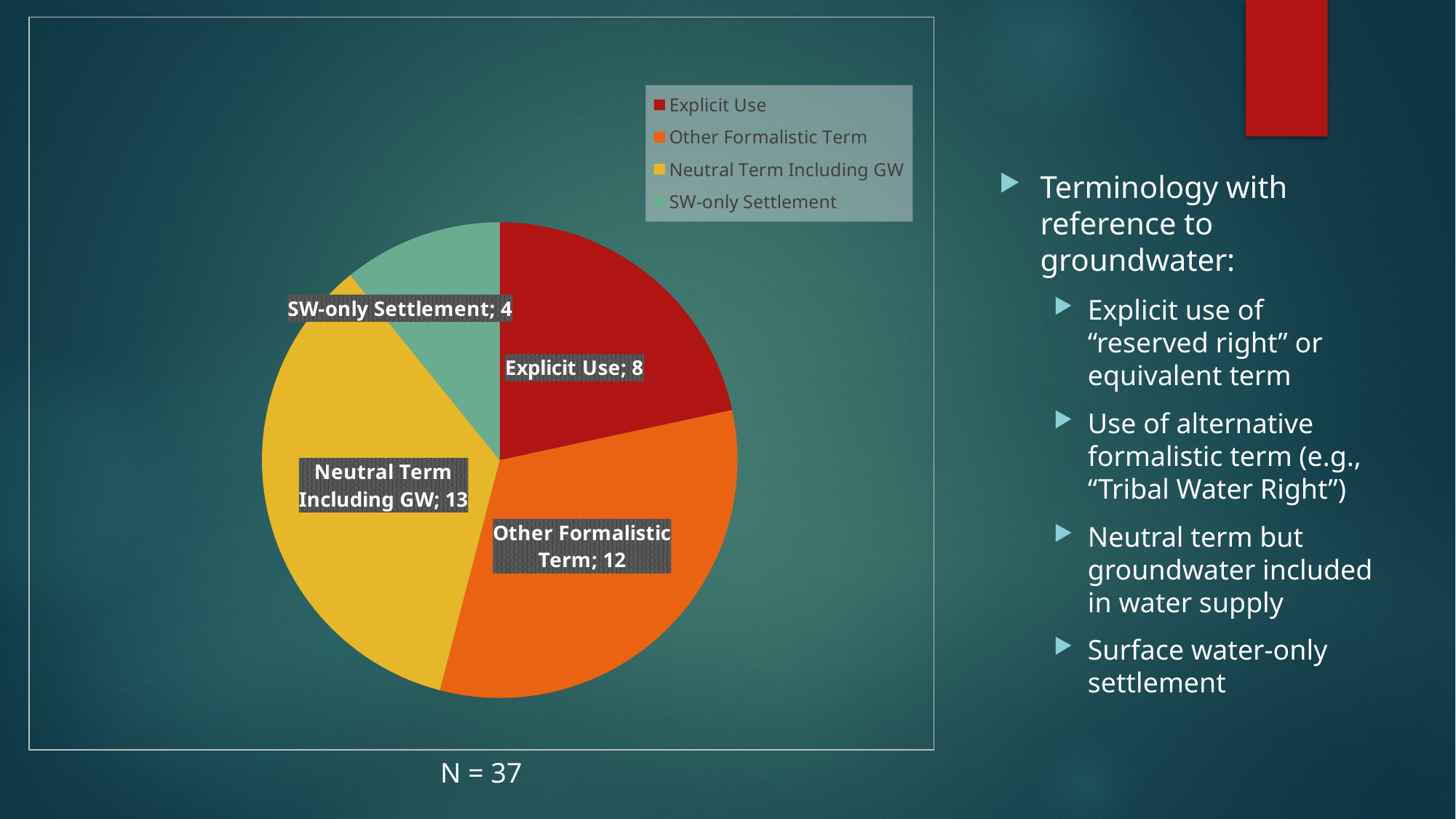
What is the total of all slices in the pie chart? 37 What colour is the Neutral Term Including GW slice? yellow What kind of chart is shown on the slide? pie chart What is the value for Other Formalistic Term? 12 What is the value for Explicit Use? 8 What is the value for Neutral Term Including GW? 13 What is the value for SW-only Settlement? 4 Which category has the smallest slice? SW-only Settlement Which is larger, Explicit Use or SW-only Settlement? Explicit Use How many categories does the pie chart have? 4 What is the difference between the values for Other Formalistic Term and Explicit Use? 4 Which category has the largest slice? Neutral Term Including GW